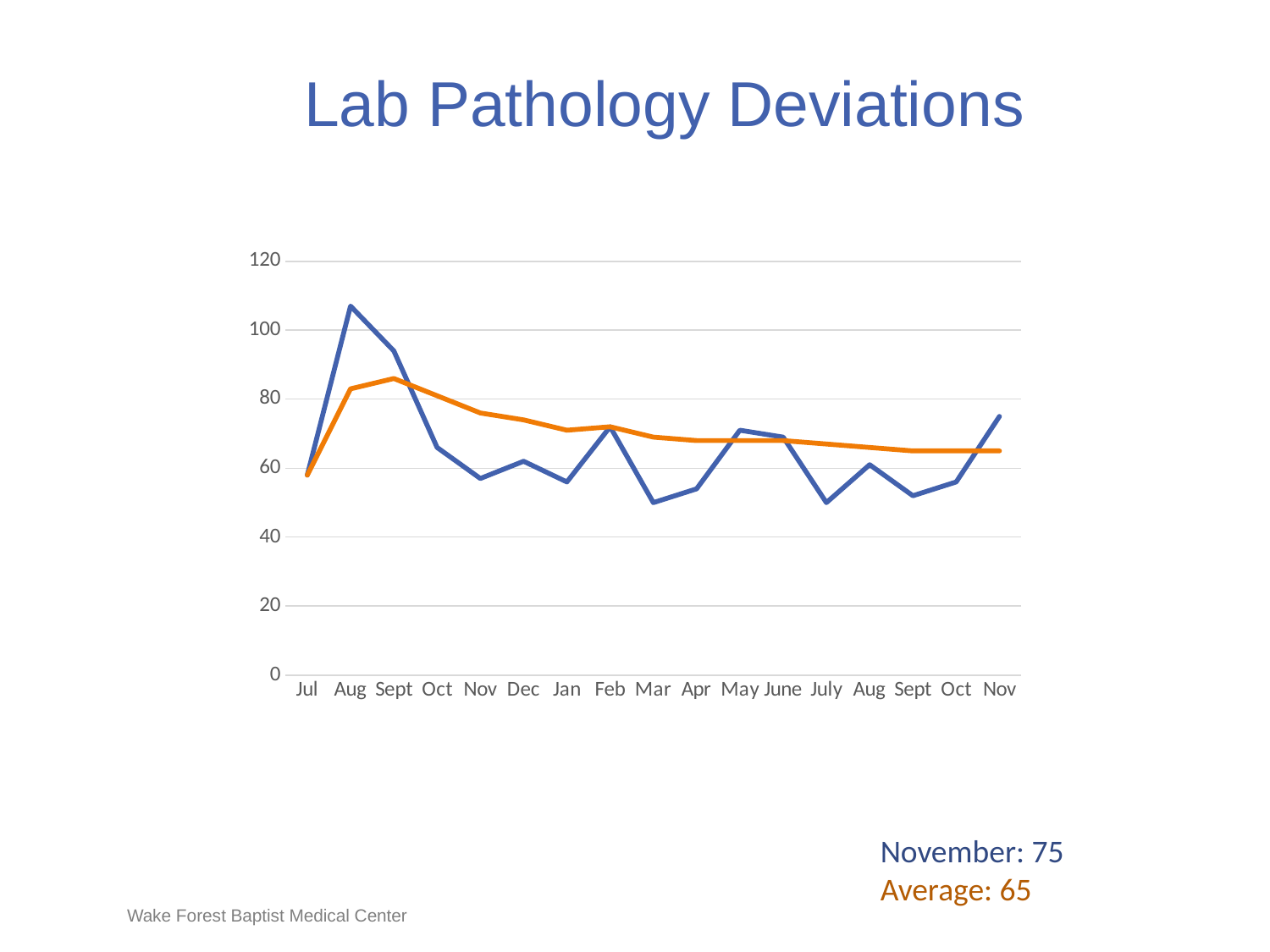
What is the average value stated on the slide? 65 What is the title of the chart? Lab Pathology Deviations How many months are labelled along the x axis? 17 How many lines are plotted on the chart? 2 In which month does the blue line reach its highest value? Aug (the first Aug) Is the blue line's value for Mar greater or less than 60? less On the blue line, which is larger: the value for Feb or the value for Mar? Feb What type of chart is shown on the slide? line chart What is the difference between the November value and the average stated on the slide? 10 Is the blue line's value for the first Aug greater or less than 100? greater Does the orange line rise or fall from Sept (the first Sept) to the final Nov? fall What is the value for the final Nov point on the blue line, as stated on the slide? 75